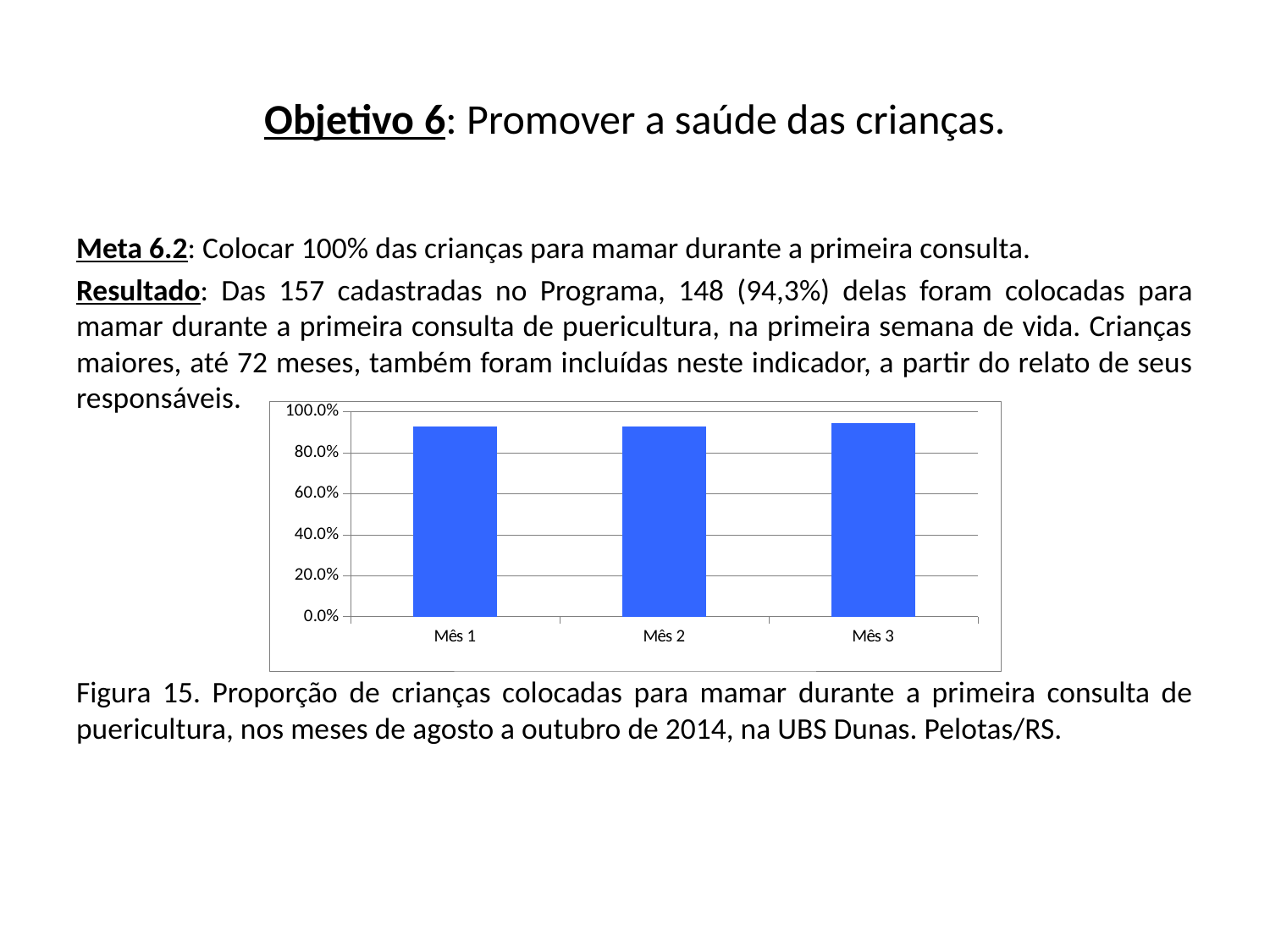
Is the value for Mês 1 greater or less than 80.0%? greater How many bars (categories) does the chart show? 3 What colour are the bars in the chart? blue Is the value for Mês 3 greater or less than 80.0%? greater What are the category labels on the x axis of the chart? Mês 1, Mês 2, Mês 3 What kind of chart is shown on the slide? bar chart Is the value for Mês 3 greater or less than 100.0%? less